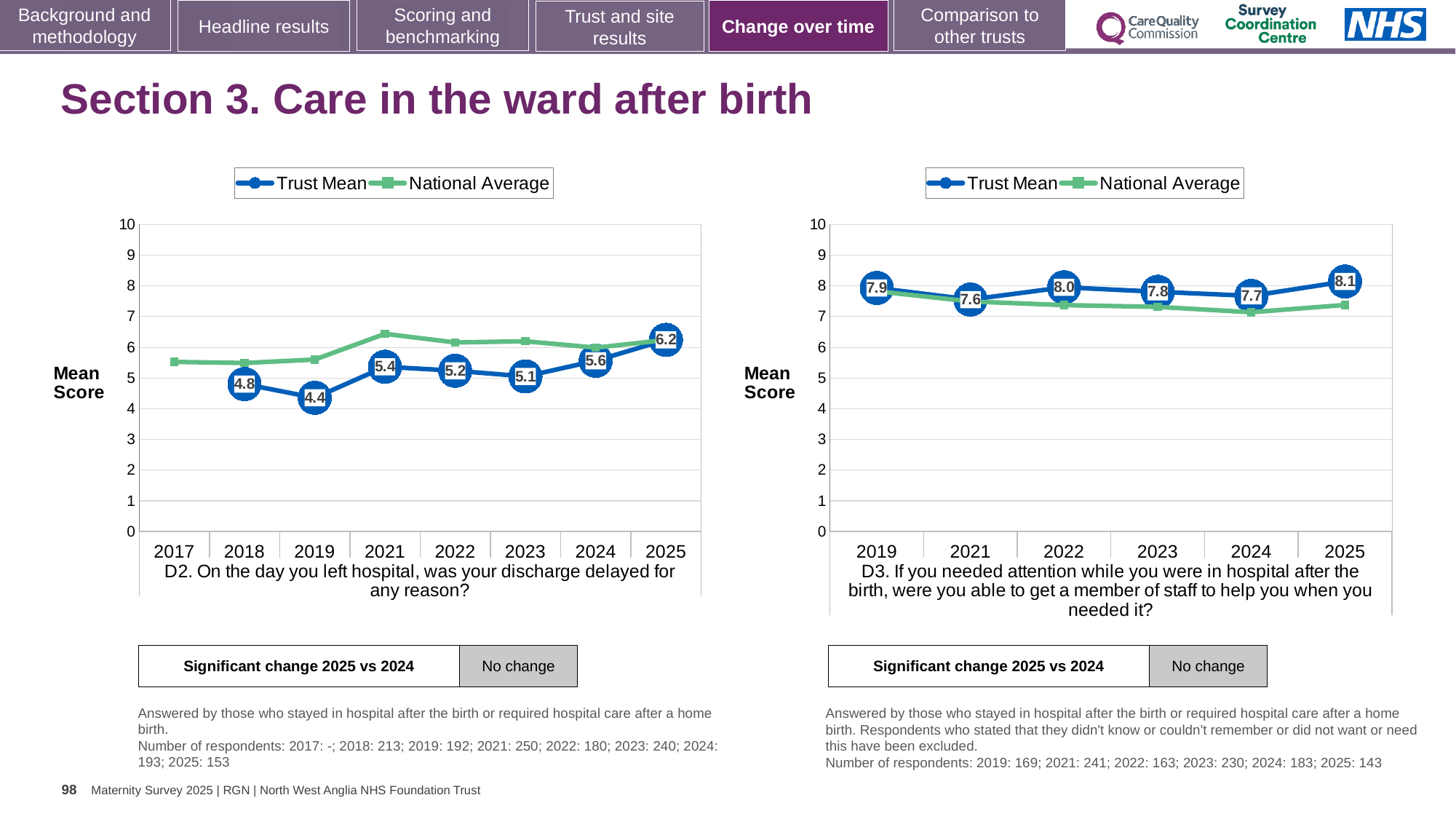
What kind of chart is the D3 chart on the right? Line chart In the D3 chart on the right, what is the Trust Mean score for 2021? 7.6 In the D3 chart on the right, which is larger, the Trust Mean for 2022 or for 2024? 2022 In the D2 chart on the left, how many years are shown on the x axis? 8 In the D2 chart on the left, which year has the highest Trust Mean score? 2025 In the D3 chart on the right, how many series does the legend list? 2 In the D2 chart on the left, is the National Average for 2017 greater or less than 6? less In the D2 chart on the left, what is the difference between the Trust Mean scores for 2025 and 2024? 0.6 In the D2 chart on the left, what is the Trust Mean score for 2019? 4.4 In the D2 chart on the left, which year has the lowest Trust Mean score? 2019 In the D3 chart on the right, which year has the highest Trust Mean score? 2025 In the D2 chart on the left, what is the Trust Mean score for 2025? 6.2